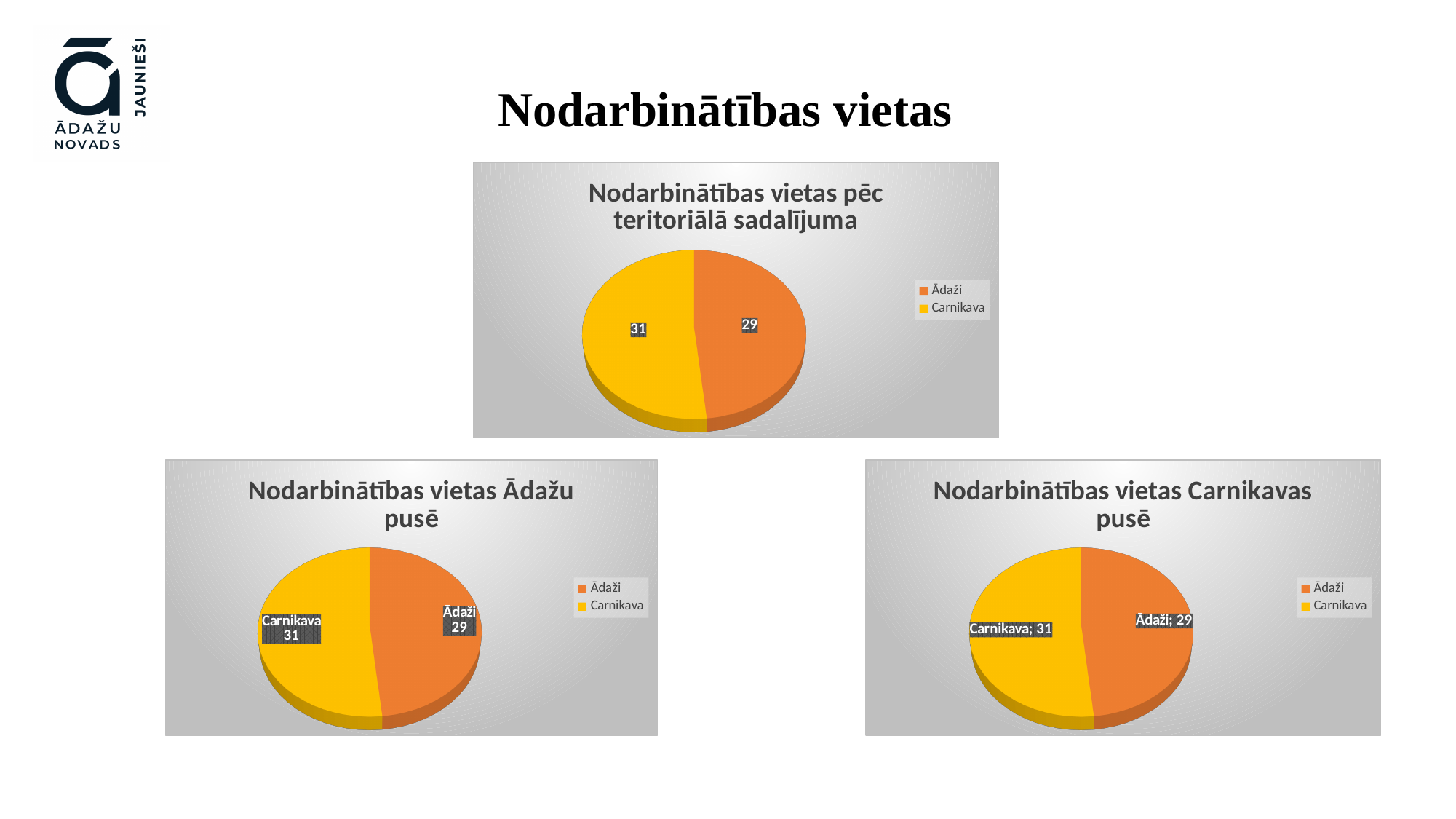
How many entries does the legend of the top chart 'Nodarbinātības vietas pēc teritoriālā sadalījuma' list? 2 What kind of chart is the bottom-left chart 'Nodarbinātības vietas Ādažu pusē'? Pie chart In the top chart 'Nodarbinātības vietas pēc teritoriālā sadalījuma', what is the value for Carnikava? 31 In the bottom-right chart 'Nodarbinātības vietas Carnikavas pusē', what is the value for Ādaži? 29 In the bottom-left chart 'Nodarbinātības vietas Ādažu pusē', which colour represents Carnikava? Yellow How many slices does the bottom-right chart 'Nodarbinātības vietas Carnikavas pusē' have? 2 In the bottom-right chart 'Nodarbinātības vietas Carnikavas pusē', is the value for Carnikava larger or smaller than the value for Ādaži? Larger In the top chart 'Nodarbinātības vietas pēc teritoriālā sadalījuma', what is the difference between the Carnikava and Ādaži values? 2 In the top chart 'Nodarbinātības vietas pēc teritoriālā sadalījuma', what is the value for Ādaži? 29 In the bottom-left chart 'Nodarbinātības vietas Ādažu pusē', which category has the smaller slice? Ādaži In the top chart 'Nodarbinātības vietas pēc teritoriālā sadalījuma', which category has the larger slice? Carnikava In the bottom-left chart 'Nodarbinātības vietas Ādažu pusē', what is the value for Carnikava? 31